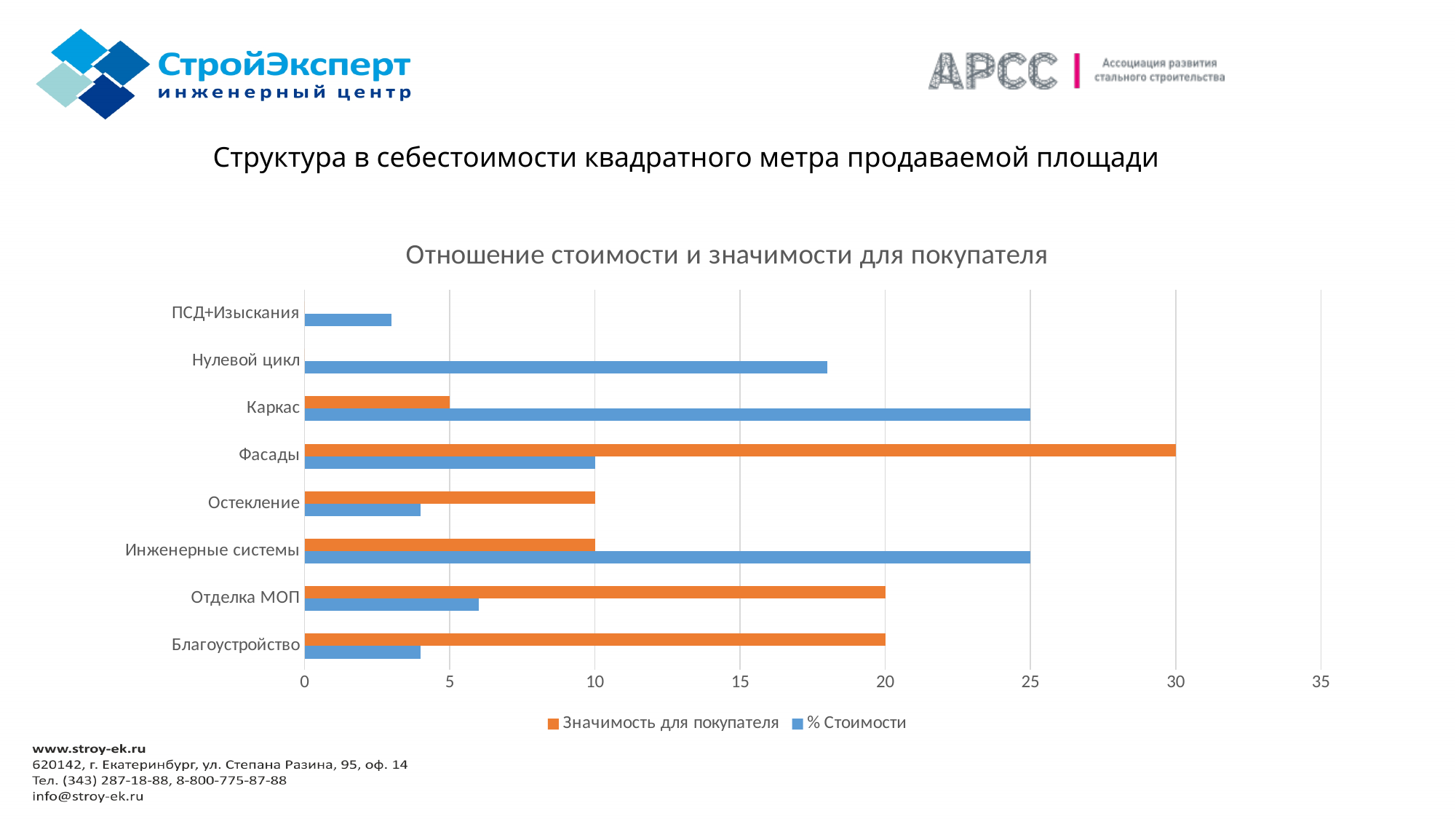
Which category has the highest value for "Значимость для покупателя"? Фасады How many categories are shown on the chart? 8 What is the title of the chart? Отношение стоимости и значимости для покупателя What is the value of "Значимость для покупателя" for Фасады? 30 For Отделка МОП, which is larger: "Значимость для покупателя" or "% Стоимости"? Значимость для покупателя What is the value of "Значимость для покупателя" for Каркас? 5 What is the value of "% Стоимости" for Каркас? 25 What is the difference between "Значимость для покупателя" and "% Стоимости" for Фасады? 20 How many series does the legend list? 2 What kind of chart is shown on the slide? bar chart Which category has the lowest value for "% Стоимости"? ПСД+Изыскания Is the value of "% Стоимости" for Нулевой цикл greater or less than 15? greater